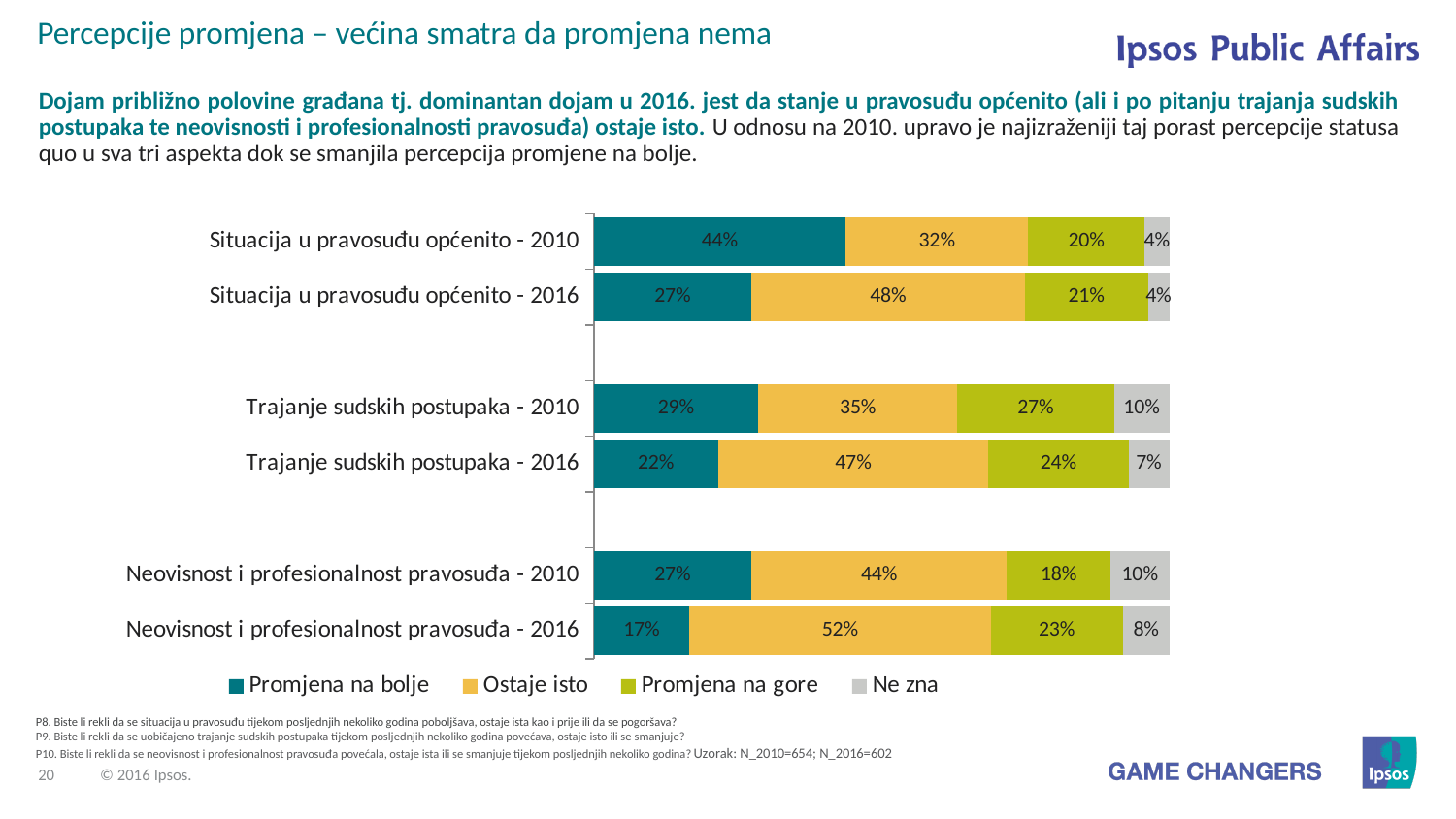
What is the "Ne zna" value for "Trajanje sudskih postupaka - 2010"? 10% Which is larger: the "Promjena na gore" value for "Trajanje sudskih postupaka - 2010" or for "Trajanje sudskih postupaka - 2016"? Trajanje sudskih postupaka - 2010 How many series does the legend list? 4 Which category has the highest "Ostaje isto" value? Neovisnost i profesionalnost pravosuđa - 2016 What is the difference between the "Promjena na bolje" values for "Situacija u pravosuđu općenito - 2010" and "Situacija u pravosuđu općenito - 2016"? 17% What kind of chart is shown on the slide? Stacked bar chart What is the total of the "Promjena na bolje" and "Ostaje isto" segments for "Trajanje sudskih postupaka - 2016"? 69% Which category has the lowest "Promjena na bolje" value? Neovisnost i profesionalnost pravosuđa - 2016 How many categories (bars) are shown in the chart? 6 What percentage of respondents said "Promjena na bolje" for "Situacija u pravosuđu općenito - 2010"? 44% Which legend entry is shown in grey? Ne zna What is the "Ostaje isto" value for "Neovisnost i profesionalnost pravosuđa - 2016"? 52%